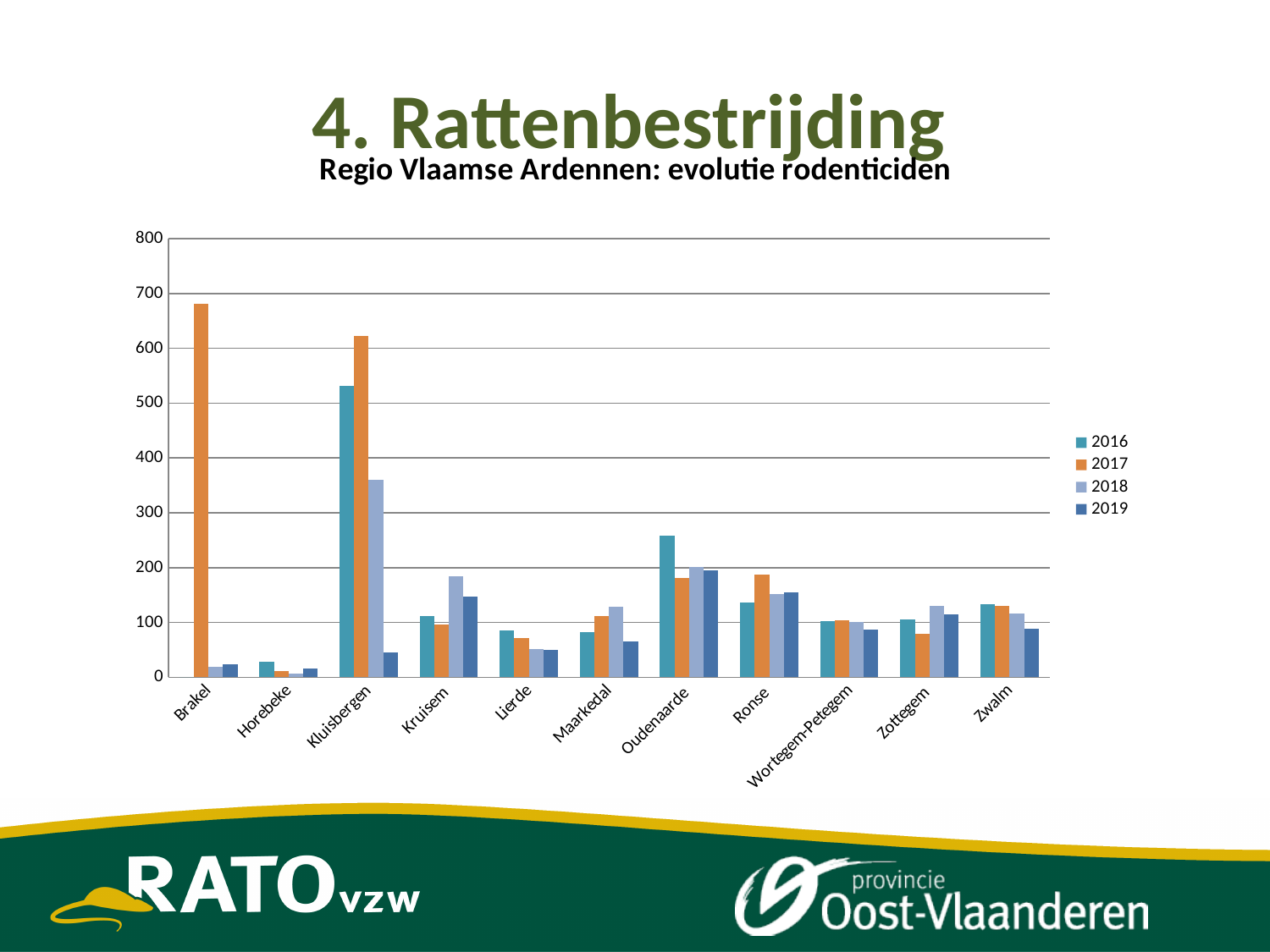
For Kluisbergen, do the values rise or fall from 2017 to 2019? fall Which years are listed in the legend of the chart? 2016, 2017, 2018, 2019 Which municipality has the tallest bar in the chart? Brakel What is the subtitle of the chart on the slide? Regio Vlaamse Ardennen: evolutie rodenticiden Is the 2018 value for Kluisbergen greater or less than 400? less Is the 2016 value for Oudenaarde greater or less than 200? greater Is the 2017 value for Brakel greater or less than 600? greater For the 2016 series, which municipality has the highest value? Kluisbergen How many series does the legend of the chart list? 4 What kind of chart is shown on the slide? bar chart Which is larger for Kluisbergen: the 2016 value or the 2017 value? 2017 How many municipalities (categories) are shown on the x axis of the chart? 11